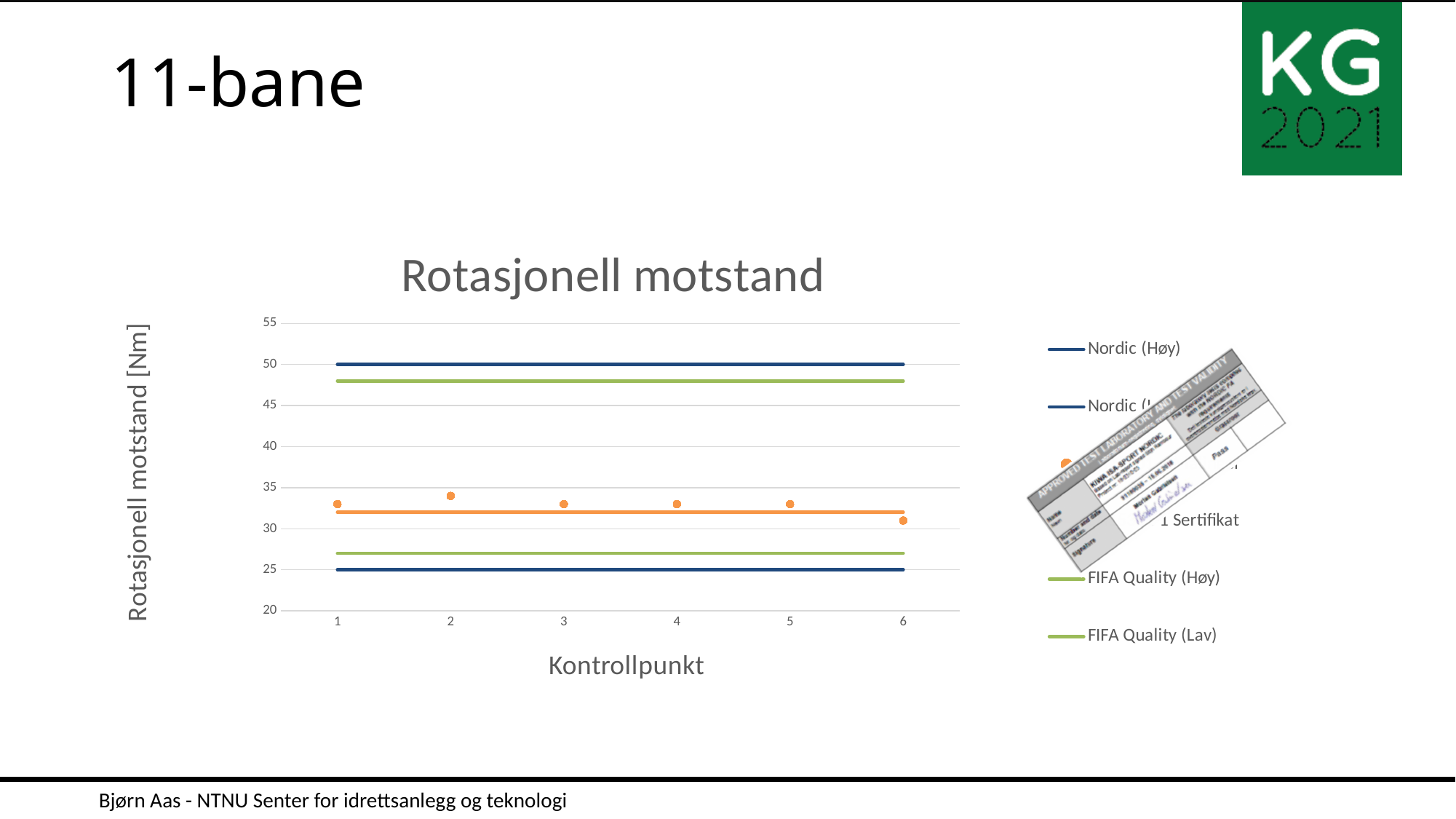
What is the value of the Nordic (Lav) line? 25 Is the FIFA Quality (Høy) line greater or less than 45? greater What is the value of the Nordic (Høy) line? 50 What is the label of the y axis? Rotasjonell motstand [Nm] What is the title of the chart? Rotasjonell motstand What type of chart is shown on the slide? line chart Which is higher, the Nordic (Høy) line or the FIFA Quality (Høy) line? Nordic (Høy) Which is higher, the Nordic (Lav) line or the FIFA Quality (Lav) line? FIFA Quality (Lav) How many kontrollpunkt are shown on the x axis? 6 What is the difference between the Nordic (Høy) line and the Nordic (Lav) line? 25 At which kontrollpunkt is the measured (orange dot) value lowest? 6 Is the FIFA Quality (Lav) line greater or less than 30? less